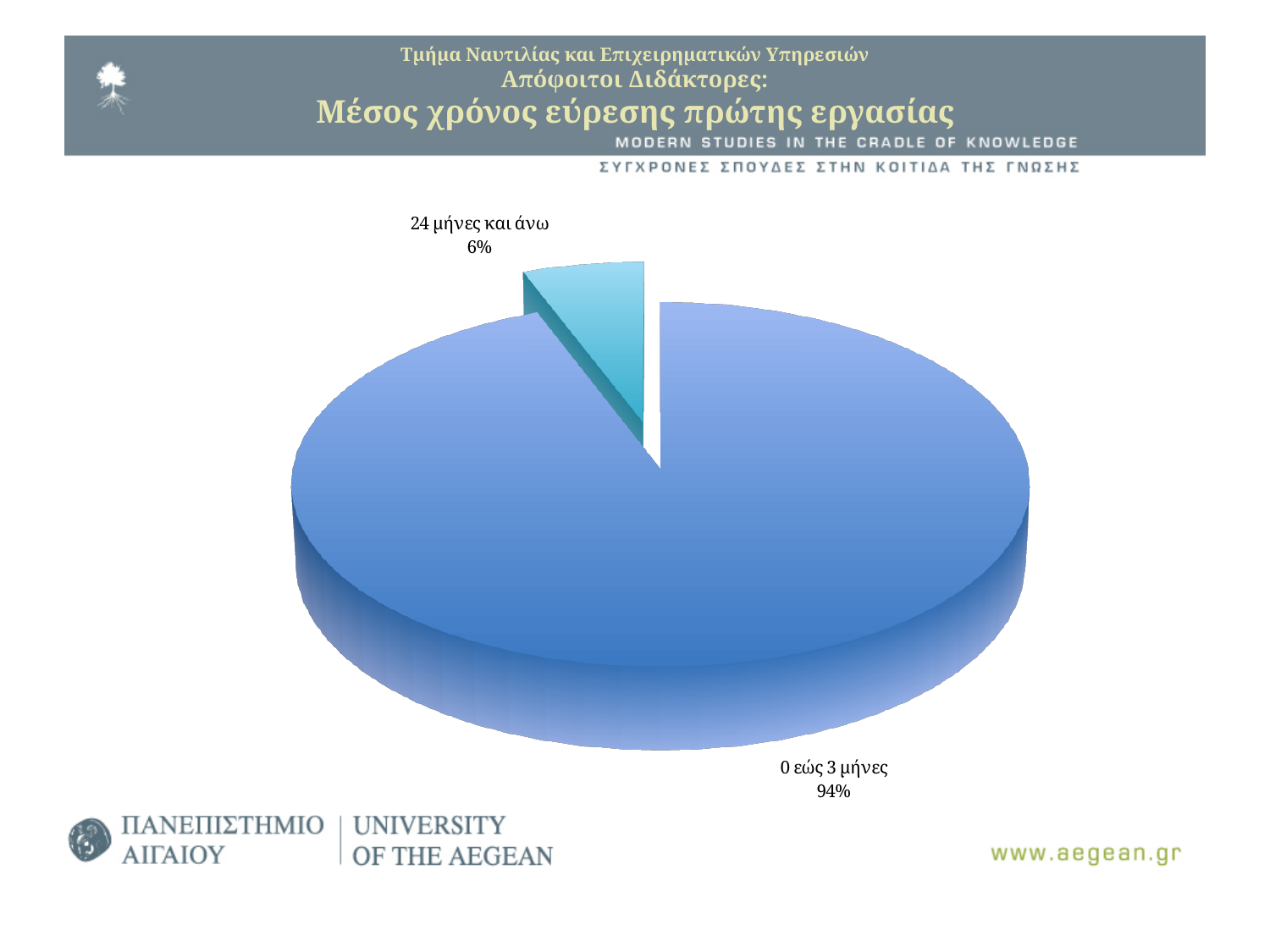
What is the main title of the chart on the slide? Μέσος χρόνος εύρεσης πρώτης εργασίας Is the share for "24 μήνες και άνω" greater or less than 10%? less Which category has the largest slice of the pie? 0 εώς 3 μήνες Is the share for "0 εώς 3 μήνες" greater or less than 90%? greater What share of the pie does the "0 εώς 3 μήνες" slice represent? 94% What is the difference in percentage points between the "0 εώς 3 μήνες" slice and the "24 μήνες και άνω" slice? 88 How many slices does the pie chart have? 2 What share of the pie does the "24 μήνες και άνω" slice represent? 6% Which is larger, the "0 εώς 3 μήνες" slice or the "24 μήνες και άνω" slice? 0 εώς 3 μήνες What kind of chart is shown on the slide? Pie chart Which category has the smallest slice of the pie? 24 μήνες και άνω What colour is the "24 μήνες και άνω" slice? Light blue (cyan)